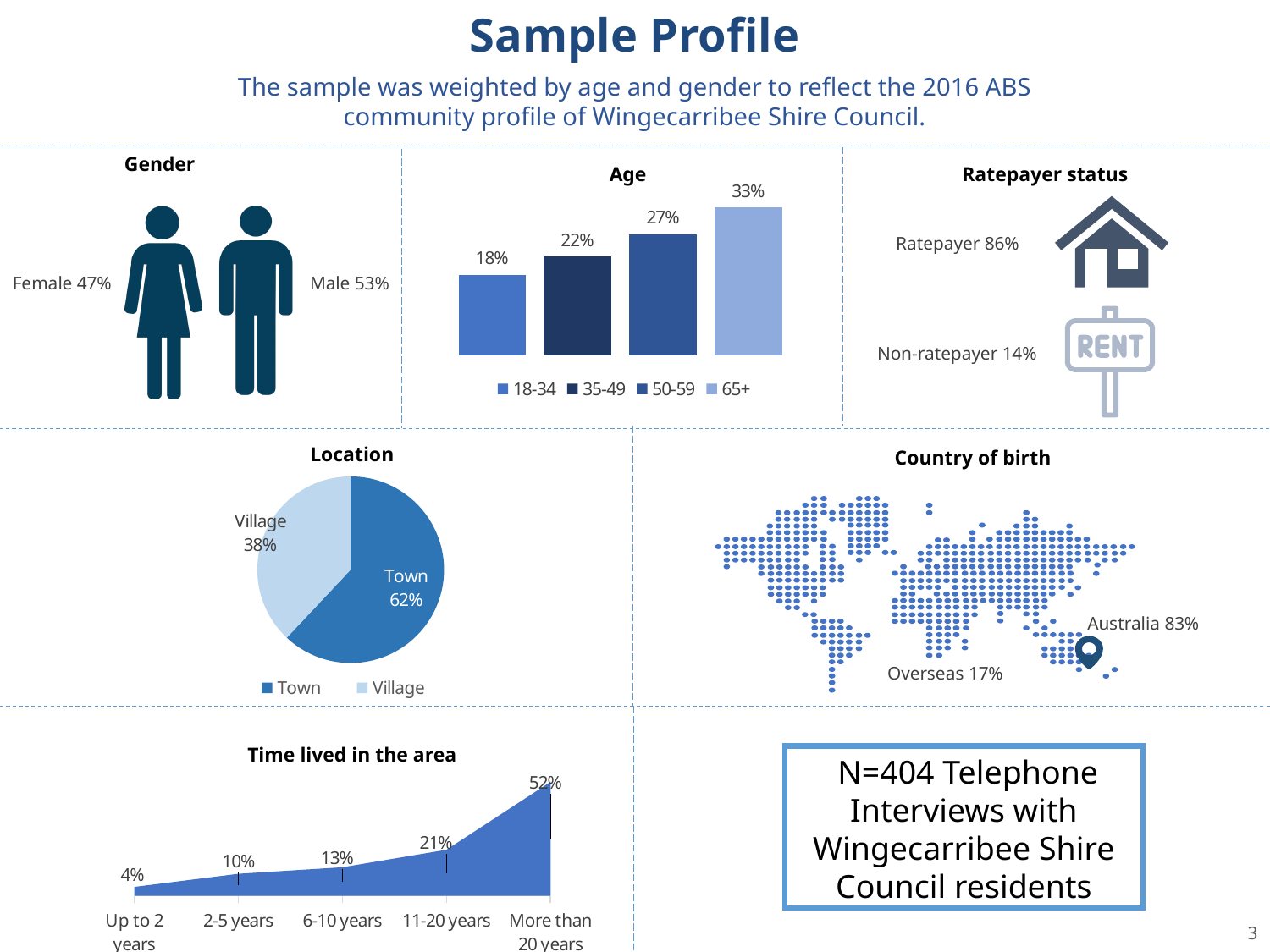
What kind of chart is the Location chart? pie chart In the Age chart, how many entries does the legend list? 4 In the Time lived in the area chart, what is the difference between the 6-10 years and 2-5 years values? 3% In the Age chart, which age group has the lowest value? 18-34 In the Time lived in the area chart, how many categories are shown on the x axis? 5 In the Time lived in the area chart, what is the value for 11-20 years? 21% In the Time lived in the area chart, which category has the highest value? More than 20 years In the Age chart, do the values rise or fall from left to right across the age groups? rise In the Location chart, what share of the pie is Village? 38% In the Location chart, which is larger, Town or Village? Town In the Age chart, what is the value for the 65+ group? 33% In the Age chart, what is the difference between the 65+ and 18-34 values? 15%